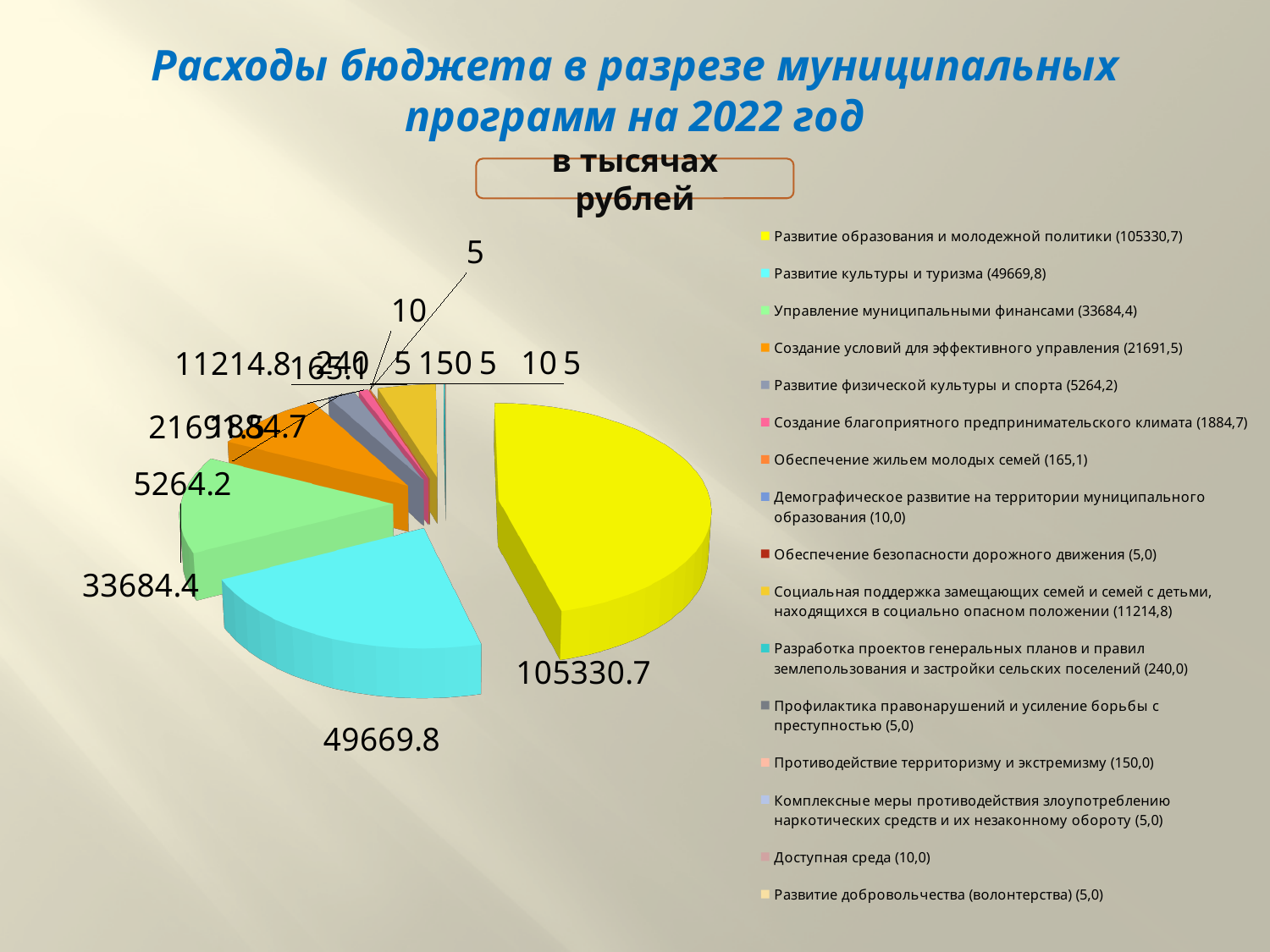
Which program has the largest share of the budget expenses? Развитие образования и молодежной политики What is the value for Социальная поддержка замещающих семей и семей с детьми, находящихся в социально опасном положении? 11214.8 What is the value for Развитие культуры и туризма? 49669.8 What is the value for Управление муниципальными финансами? 33684.4 Which is larger: the value for Развитие культуры и туризма or for Управление муниципальными финансами? Развитие культуры и туризма What colour is the slice for Развитие образования и молодежной политики? yellow What is the value for Развитие физической культуры и спорта? 5264.2 What is the value for Развитие образования и молодежной политики? 105330.7 How many programs (categories) does the legend list? 16 What is the difference between the values for Развитие образования и молодежной политики and Развитие культуры и туризма? 55660.9 What kind of chart is shown on the slide? pie chart In what units are the values on the chart given? в тысячах рублей